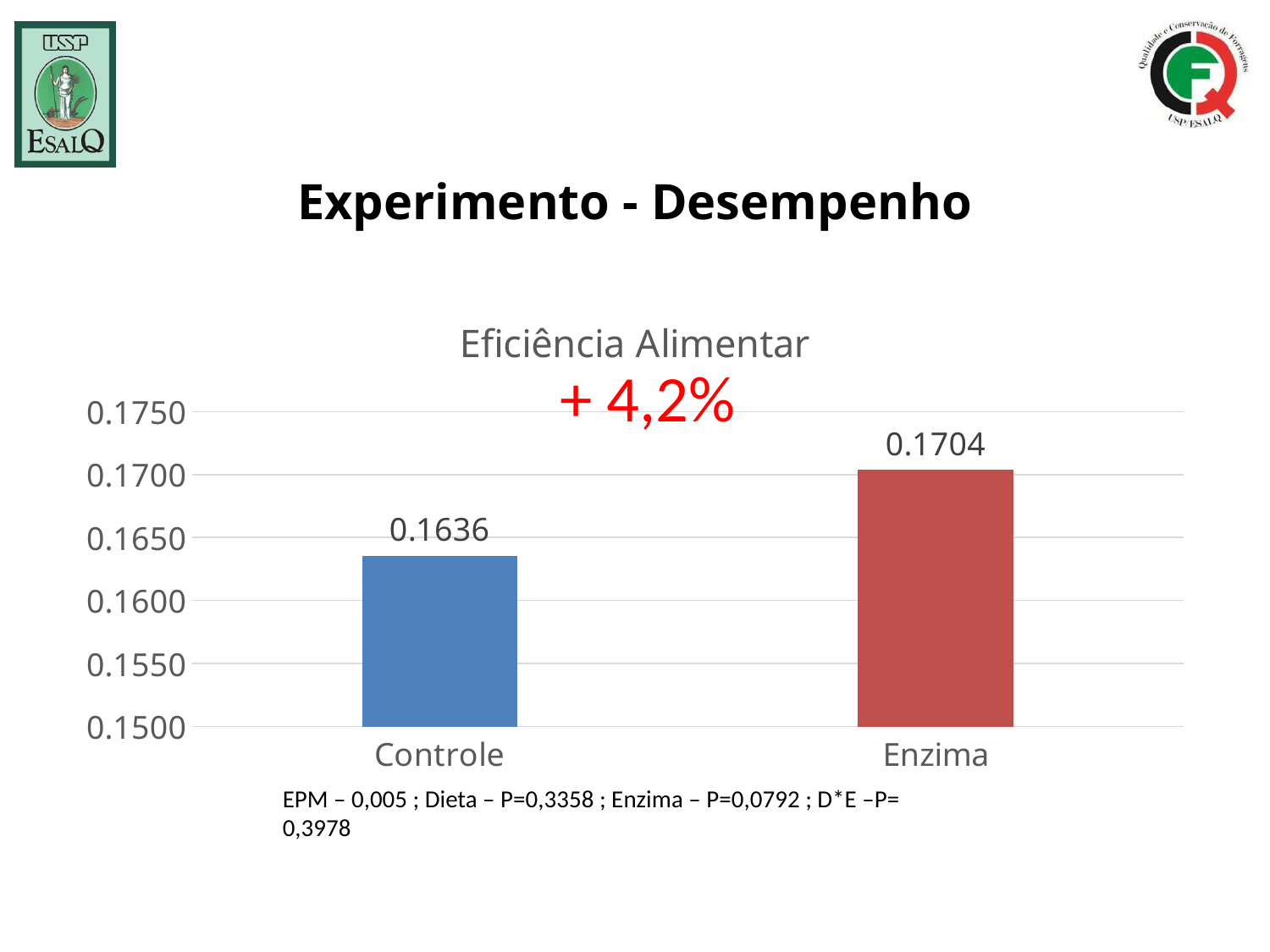
What is the difference between the values for Enzima and Controle? 0.0068 Is the value for Controle greater or less than 0.1650? less Is the value for Enzima greater or less than 0.1700? greater What is the value for Controle? 0.1636 How many categories are shown in the chart? 2 What is the value for Enzima? 0.1704 Which is larger, the value for Controle or the value for Enzima? Enzima Which category has the lowest value? Controle What is the title of the chart? Eficiência Alimentar Which category has the highest value? Enzima What kind of chart is shown on the slide? bar chart What percentage increase is annotated in red on the chart? + 4,2%